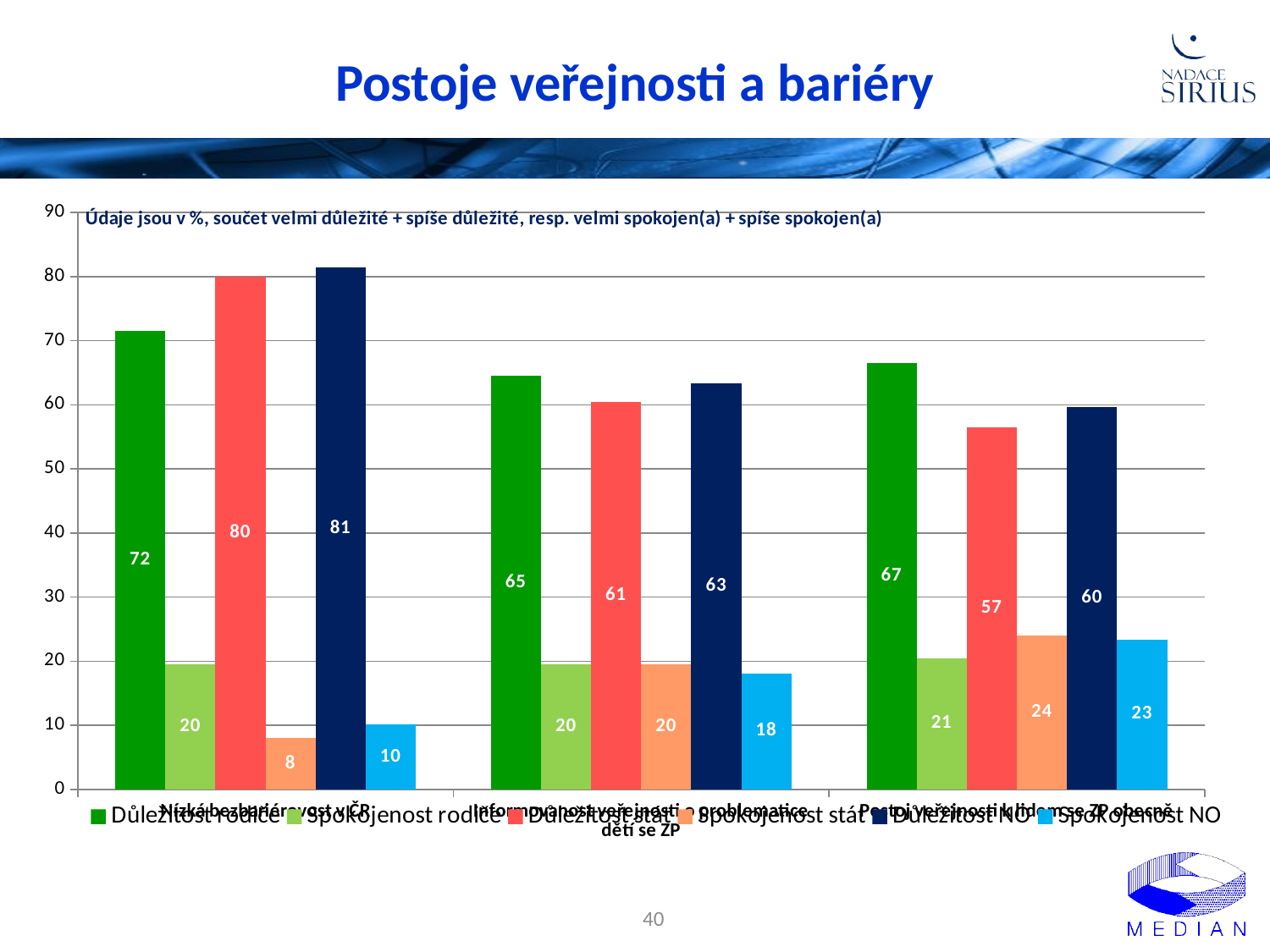
What is the value of Spokojenost NO in the third (rightmost) category group? 23 Which bar has the highest value on the chart? Důležitost NO in the first group (81) What kind of chart is shown on the slide? bar chart Does the value of Důležitost stát rise or fall from the first category group to the third? fall Is the value of Důležitost rodiče larger in the second category group or in the third category group? third group (67) How many series does the legend list? 6 What is the value of Důležitost NO in the first (leftmost) category group? 81 What is the title of the slide? Postoje veřejnosti a bariéry Which bar has the lowest value on the chart? Spokojenost stát in the first group (8) What is the value of Spokojenost stát in the first (leftmost) category group? 8 In the first (leftmost) category group, what is the difference between Důležitost stát and Spokojenost stát? 72 How many category groups are plotted along the x axis? 3